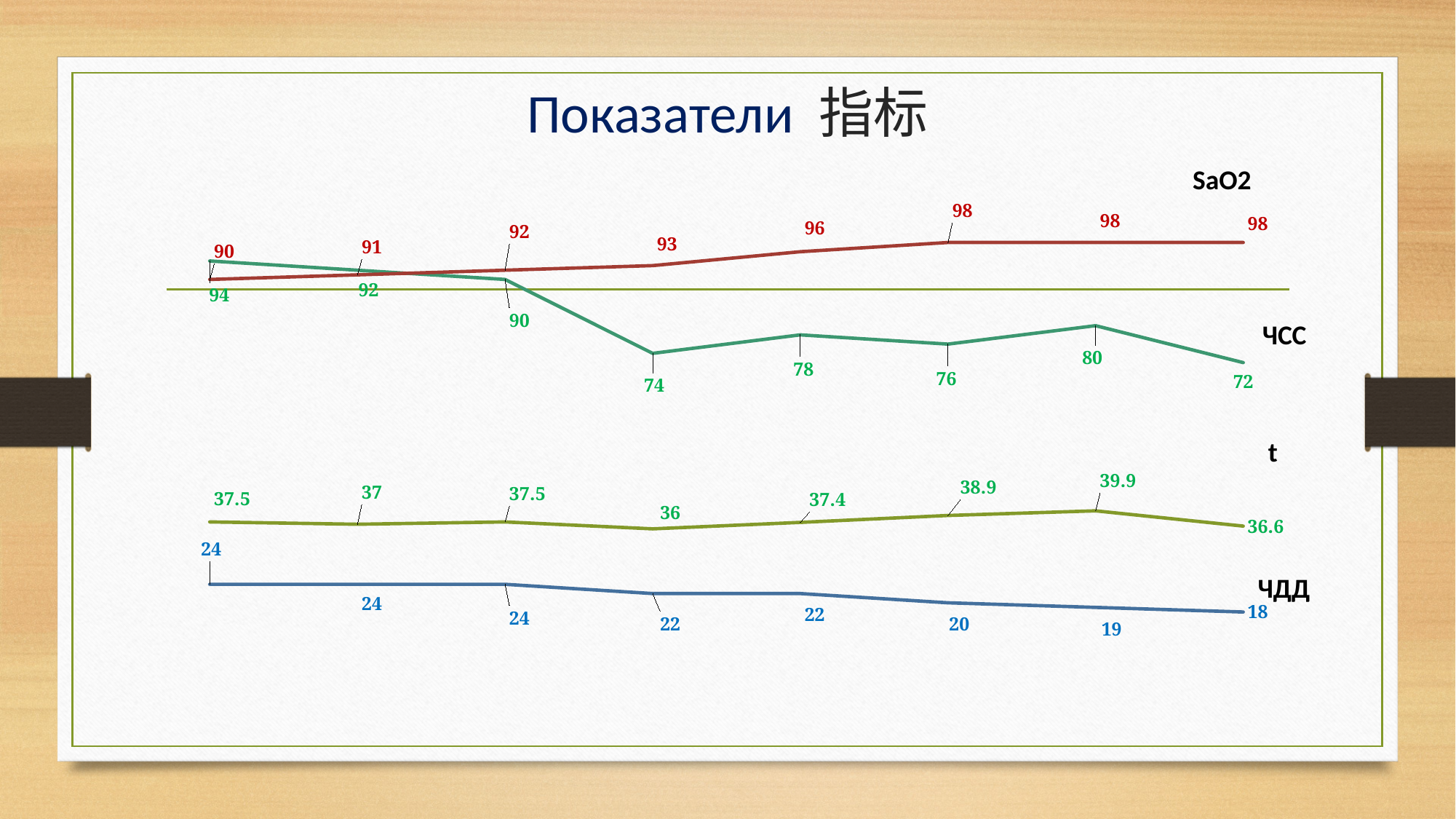
What is the highest value in the t series? 39.9 How many series are plotted on the chart? 4 Does the ЧДД series rise or fall from left to right? fall What is the lowest value in the ЧДД series? 18 What kind of chart is shown on the slide? line chart Does the SaO2 series rise or fall from left to right? rise Which is larger, the last value of SaO2 or the last value of ЧСС? SaO2 What is the lowest value in the t series? 36 What is the last value of the ЧСС series? 72 How many data points does the SaO2 series have? 8 What is the first value of the SaO2 series? 90 What is the difference between the first and last values of the ЧСС series? 22